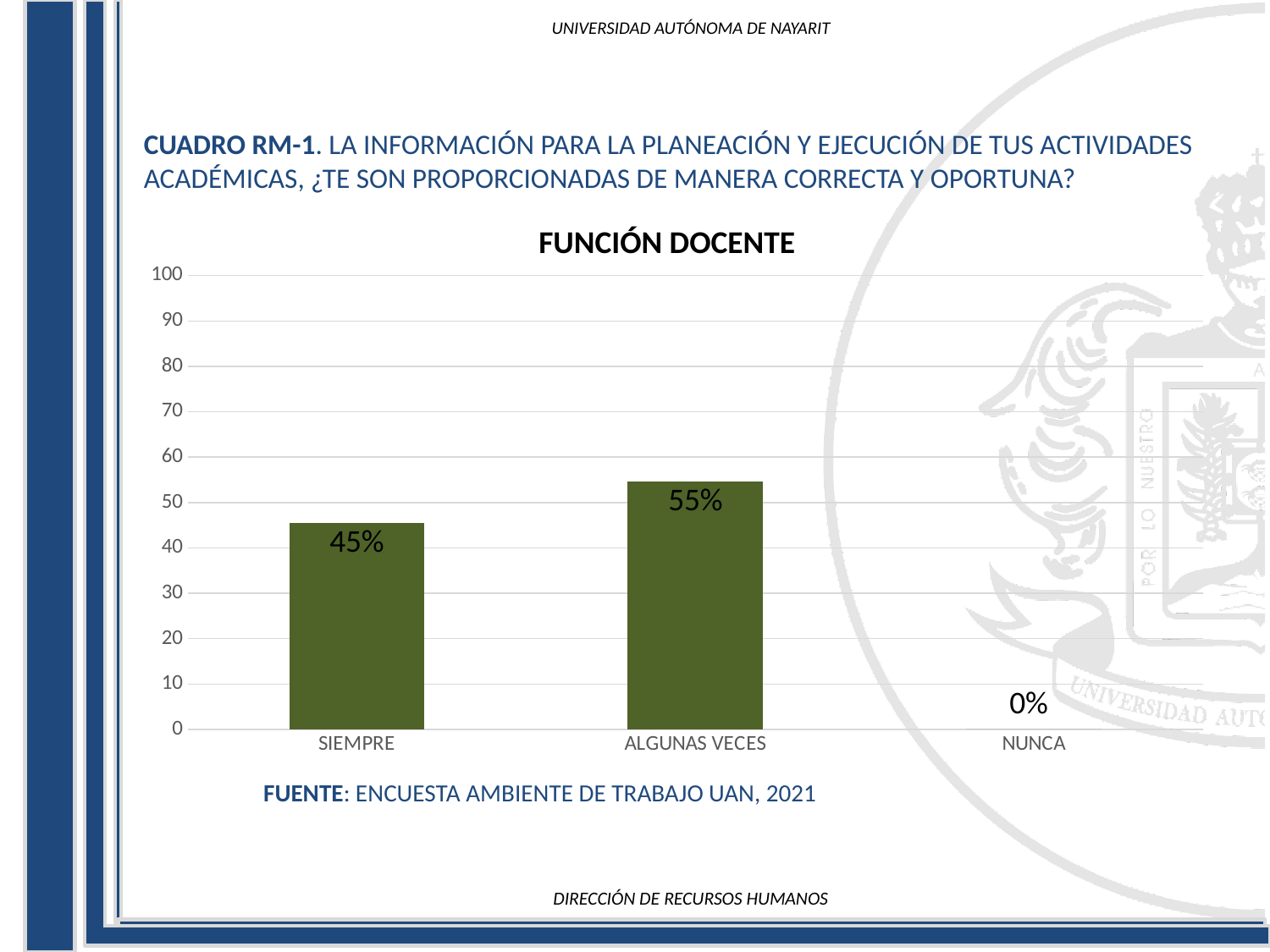
How many categories are shown on the x axis? 3 What is the value for SIEMPRE? 45% Which category has the lowest value? NUNCA Which category has the highest value? ALGUNAS VECES Which is larger, the value for SIEMPRE or the value for ALGUNAS VECES? ALGUNAS VECES What is the value for ALGUNAS VECES? 55% Is the value for SIEMPRE greater or less than 50? less What is the difference between the values for ALGUNAS VECES and SIEMPRE? 10% What is the title of the chart? FUNCIÓN DOCENTE What is the source cited below the chart? ENCUESTA AMBIENTE DE TRABAJO UAN, 2021 What kind of chart is shown on the slide? bar chart What is the value for NUNCA? 0%